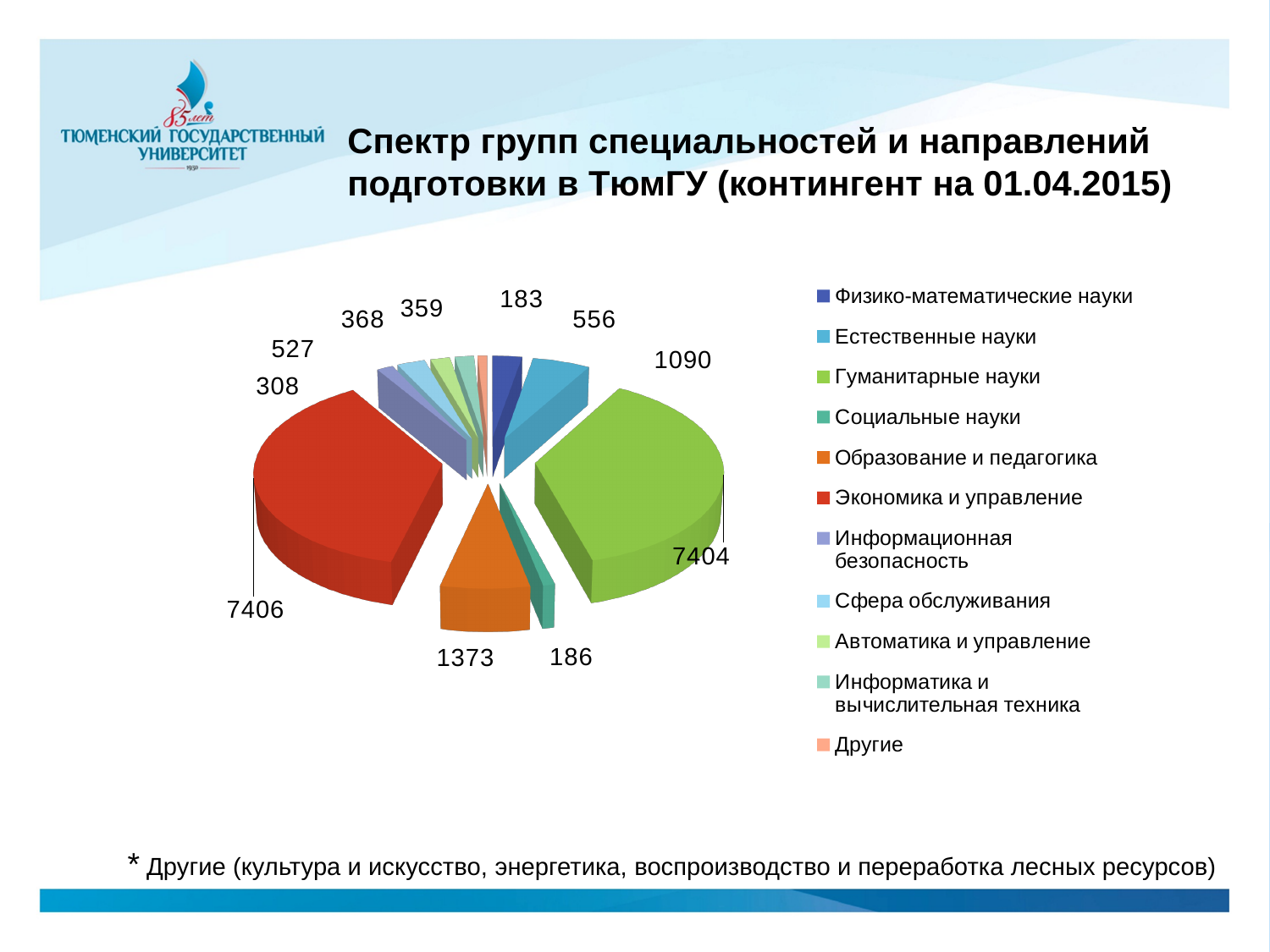
What kind of chart is shown on the slide? pie chart What is the title of the chart on the slide? Спектр групп специальностей и направлений подготовки в ТюмГУ (контингент на 01.04.2015) What is the difference between the values for Гуманитарные науки and Естественные науки? 6314 What is the value for Другие? 183 What is the value for Информационная безопасность? 308 What is the value for Физико-математические науки? 556 What is the value for Гуманитарные науки? 7404 What is the value for Естественные науки? 1090 What is the value for Экономика и управление? 7406 Which is larger, Образование и педагогика or Социальные науки? Образование и педагогика How many categories does the pie chart have? 11 What is the value for Образование и педагогика? 1373